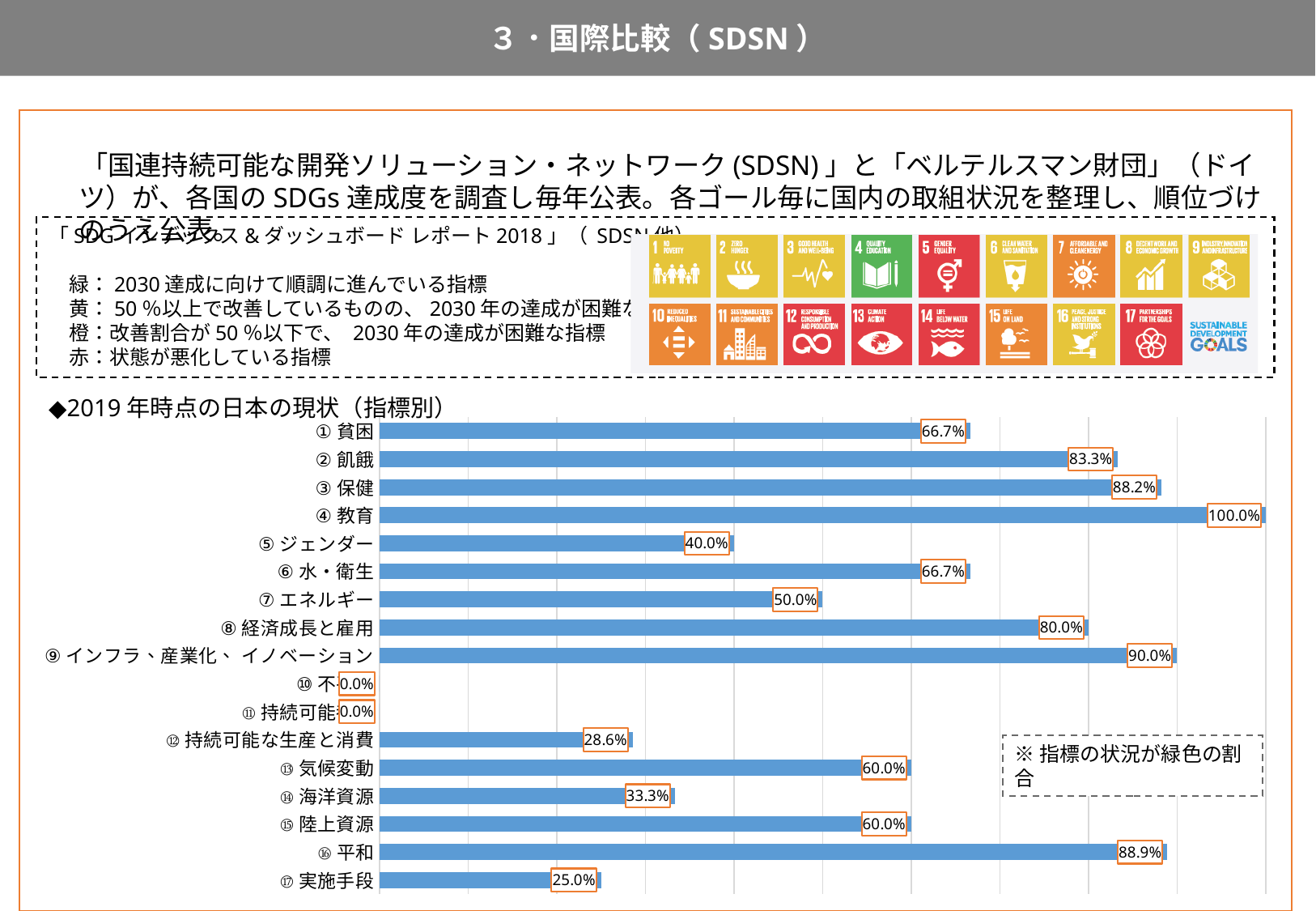
Which category has the highest value? ④ 教育 Which is larger, the value for ② 飢餓 or the value for ⑬ 気候変動? ② 飢餓 What is the value for ⑫ 持続可能な生産と消費? 28.6% What kind of chart is shown on the slide? bar chart Which is larger, the value for ⑰ 実施手段 or the value for ⑦ エネルギー? ⑦ エネルギー What is the difference between the values for ③ 保健 and ⑭ 海洋資源? 54.9% What is the value for ④ 教育? 100.0% How many categories are plotted in the chart? 17 What is the value for ⑯ 平和? 88.9% What is the value for ⑤ ジェンダー? 40.0% What is the title of the chart? ◆2019年時点の日本の現状（指標別） What is the difference between the values for ⑨ インフラ、産業化、イノベーション and ⑧ 経済成長と雇用? 10.0%